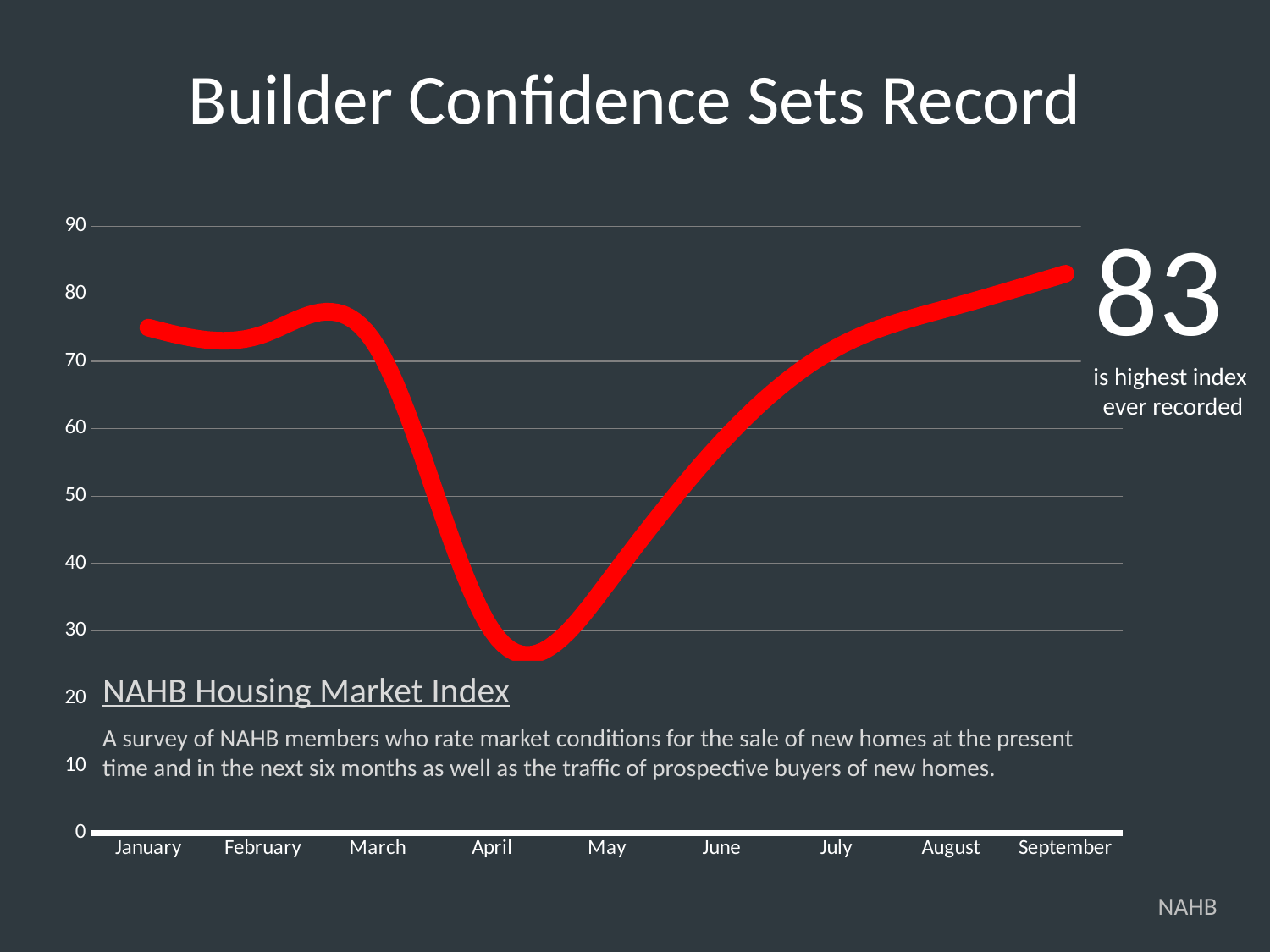
Is the value for July greater or less than 60? greater What is the NAHB Housing Market Index value for September? 83 Which is larger, the value for January or the value for April? January How many months are plotted along the x axis? 9 Which month has the lowest index value? April What kind of chart is shown on the slide? line chart Is the value for May greater or less than 50? less Is the value for January greater or less than 70? greater Do the values rise or fall from April to September? rise What is the title of the slide? Builder Confidence Sets Record Which month has the highest index value? September